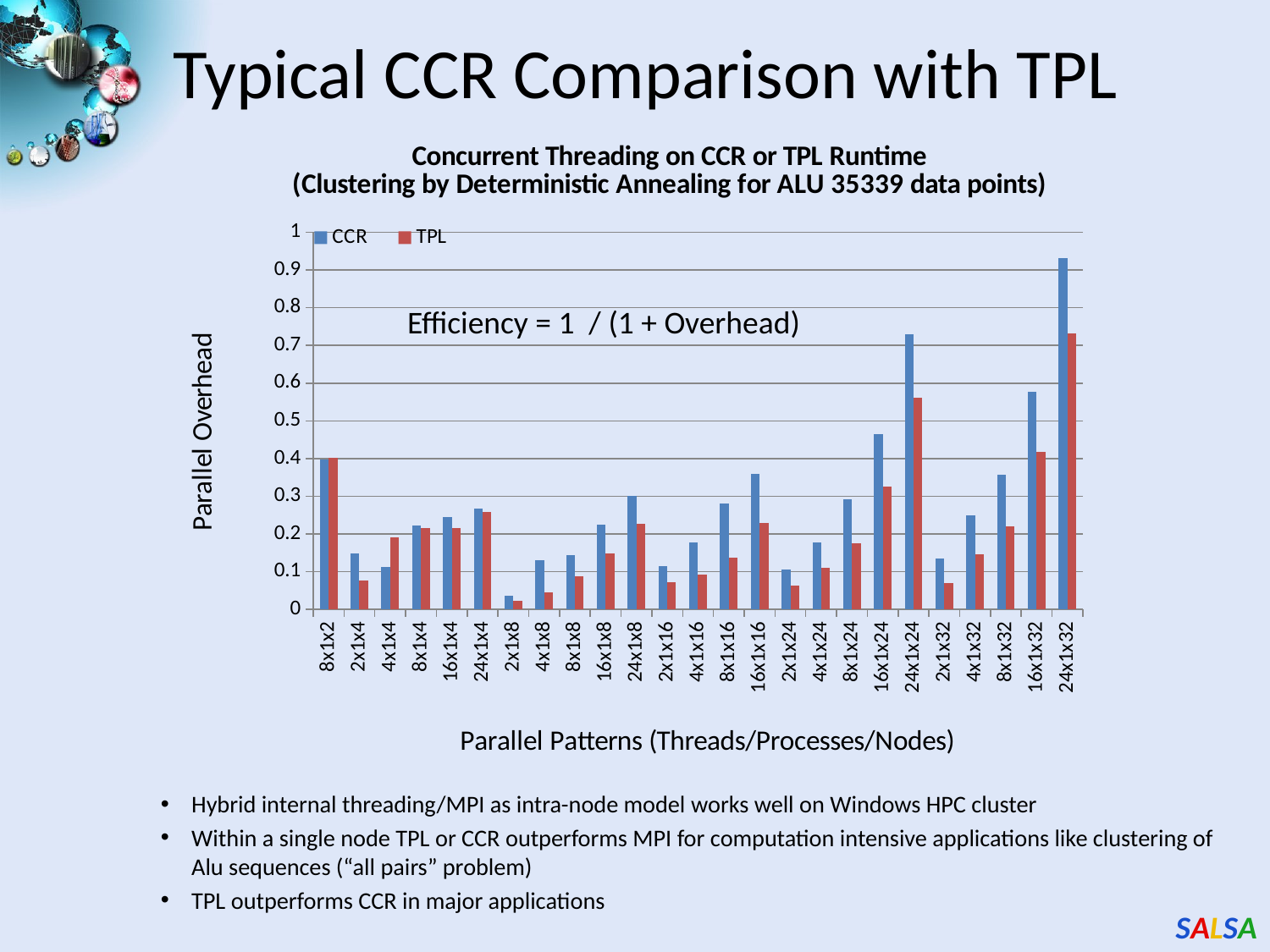
Which parallel pattern has the highest CCR parallel overhead? 24x1x32 Which parallel pattern has the highest TPL parallel overhead? 24x1x32 What is the label of the y axis? Parallel Overhead Is the TPL value for 2x1x4 greater or less than 0.1? less Is the CCR value for 24x1x32 greater or less than 0.8? greater Which parallel pattern has the lowest CCR parallel overhead? 2x1x8 What kind of chart is shown on the slide? bar chart How many series does the legend list? 2 Is the TPL value for 24x1x24 greater or less than 0.5? greater How many parallel pattern categories are shown on the x axis? 25 For 16x1x32, which is larger, the CCR value or the TPL value? CCR